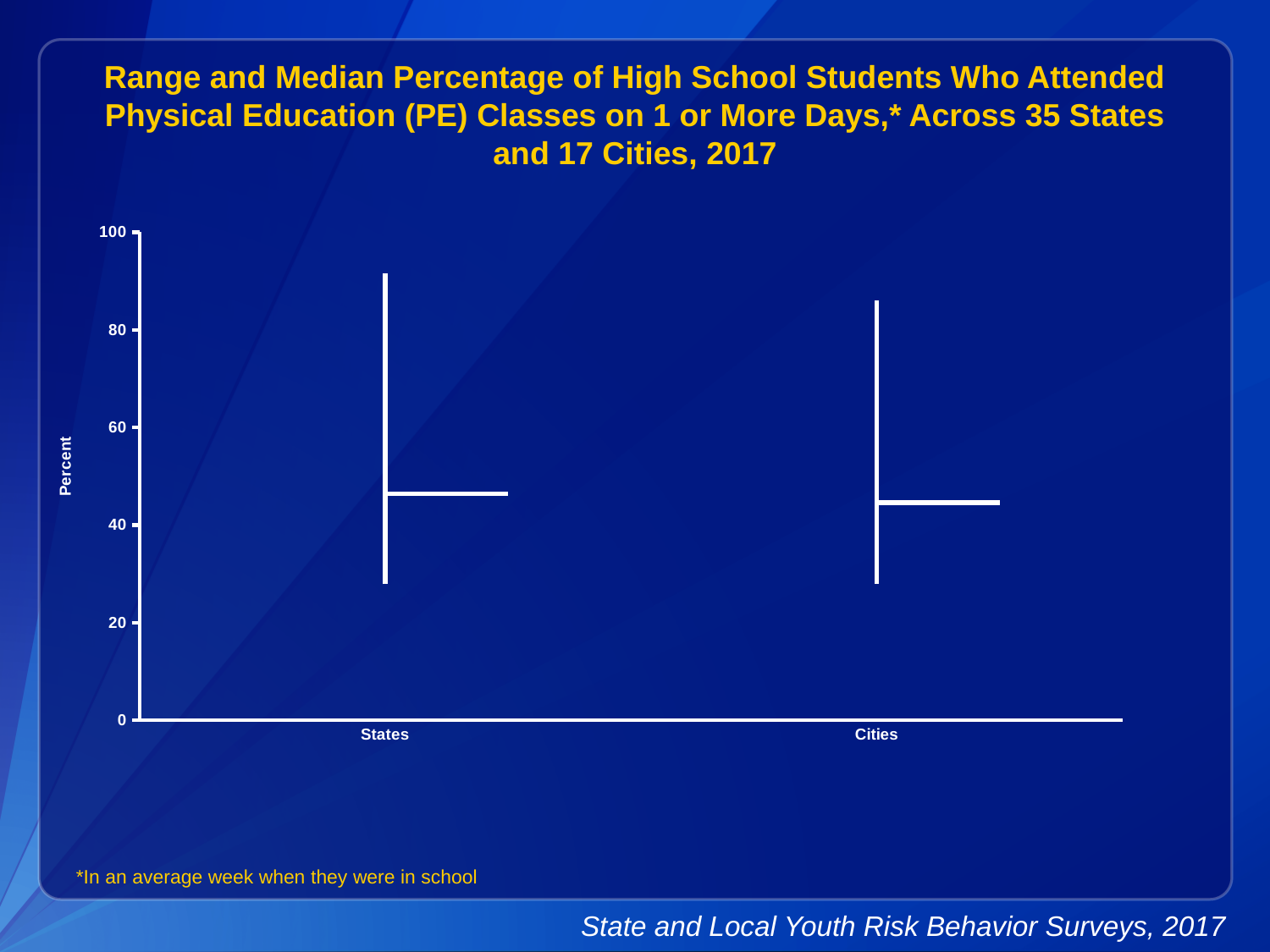
Is the top of the range for States greater or less than 80? greater How many categories are shown on the x axis of the chart? 2 What is the label of the y axis? Percent Is the median value for Cities greater or less than 60? less Is the bottom of the range for States greater or less than 40? less What is the highest value shown on the y axis? 100 Which category has the higher top of its range, States or Cities? States What are the two categories shown on the x axis? States and Cities